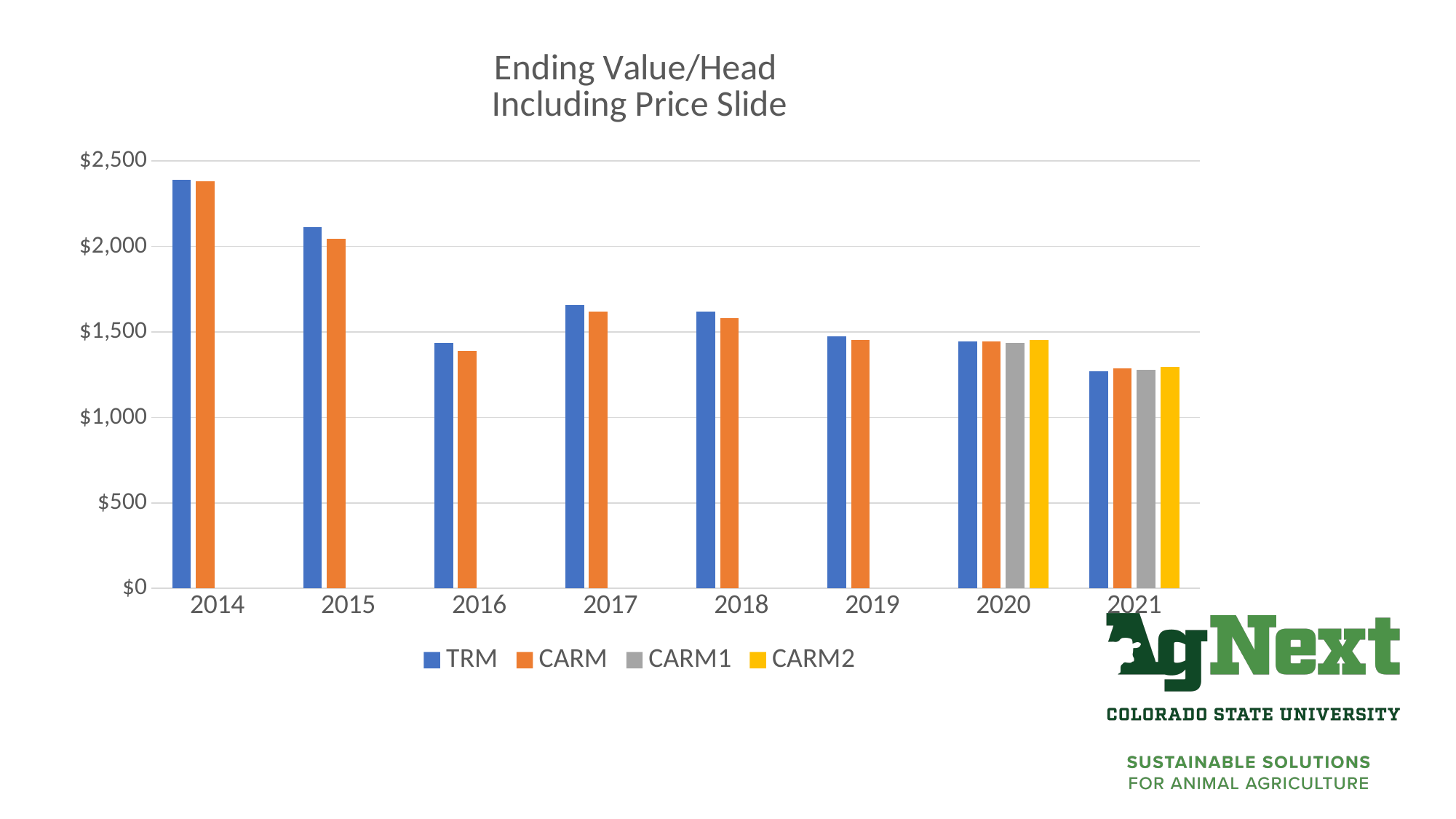
Overall, do the TRM values rise or fall from 2014 to 2021? fall How many series does the legend list? 4 Is the CARM value for 2021 greater or less than $1,500? less In which years do the CARM1 and CARM2 series have bars? 2020 and 2021 Is the TRM value for 2014 greater or less than $2,000? greater What kind of chart is shown on the slide? bar chart In which year is the TRM value lowest? 2021 In 2015, which is larger, the TRM value or the CARM value? TRM Is the TRM value for 2017 greater or less than $1,500? greater In which year is the TRM value highest? 2014 How many years are shown on the x axis? 8